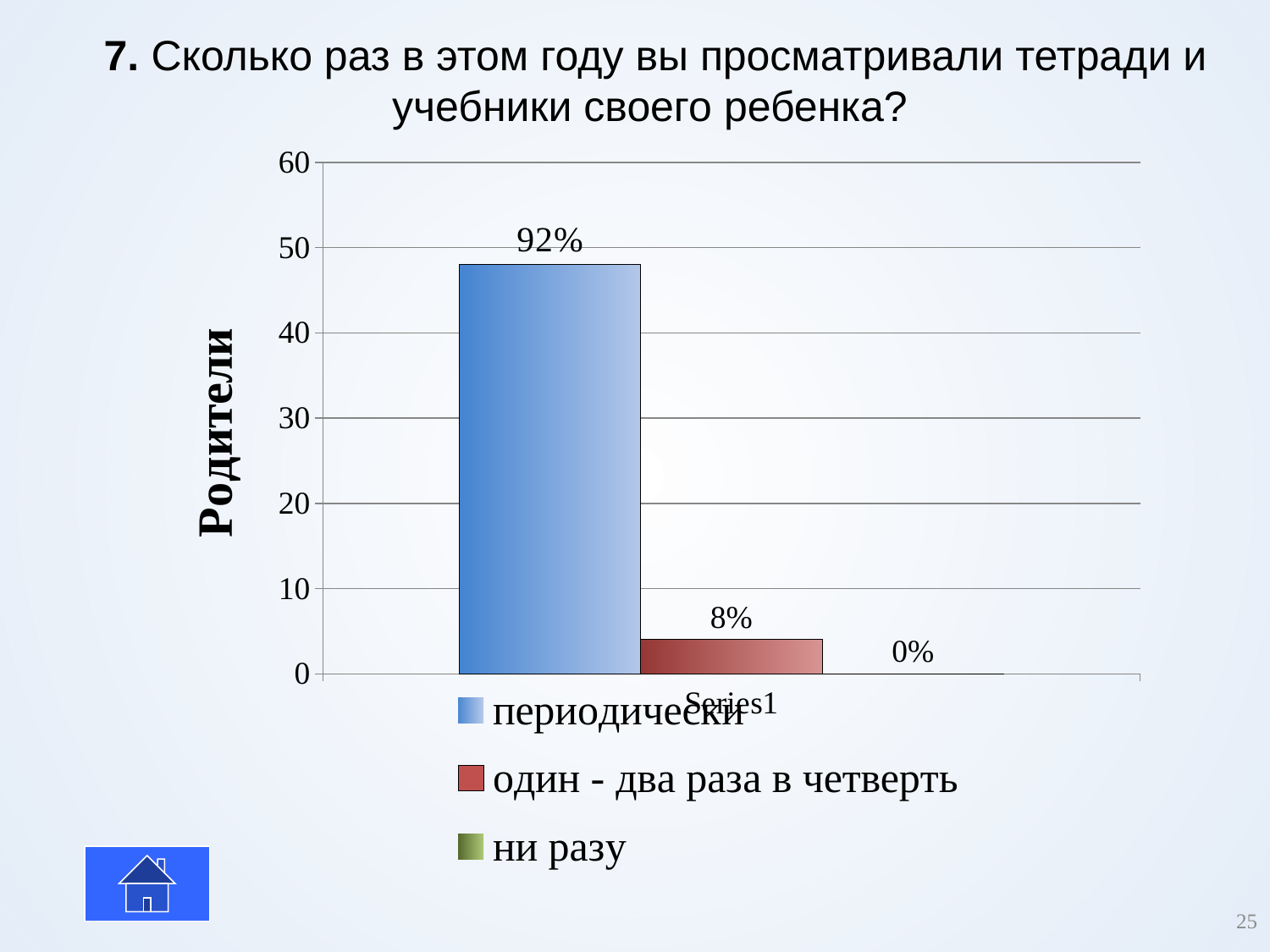
What is the data label shown for the 'один - два раза в четверть' bar? 8% What kind of chart is shown on the slide? bar chart Which is larger, the value for 'периодически' or the value for 'один - два раза в четверть'? периодически Which legend entry has the highest value? периодически What is the difference between the labelled values for 'периодически' and 'один - два раза в четверть'? 84% How many entries does the legend list? 3 Which legend entry has the lowest value? ни разу What is the data label shown for the 'периодически' bar? 92% What is the data label shown for 'ни разу'? 0% What is the label on the vertical axis of the chart? Родители Is the bar for 'один - два раза в четверть' greater or less than 10 on the vertical axis? less Is the bar for 'периодически' greater or less than 40 on the vertical axis? greater